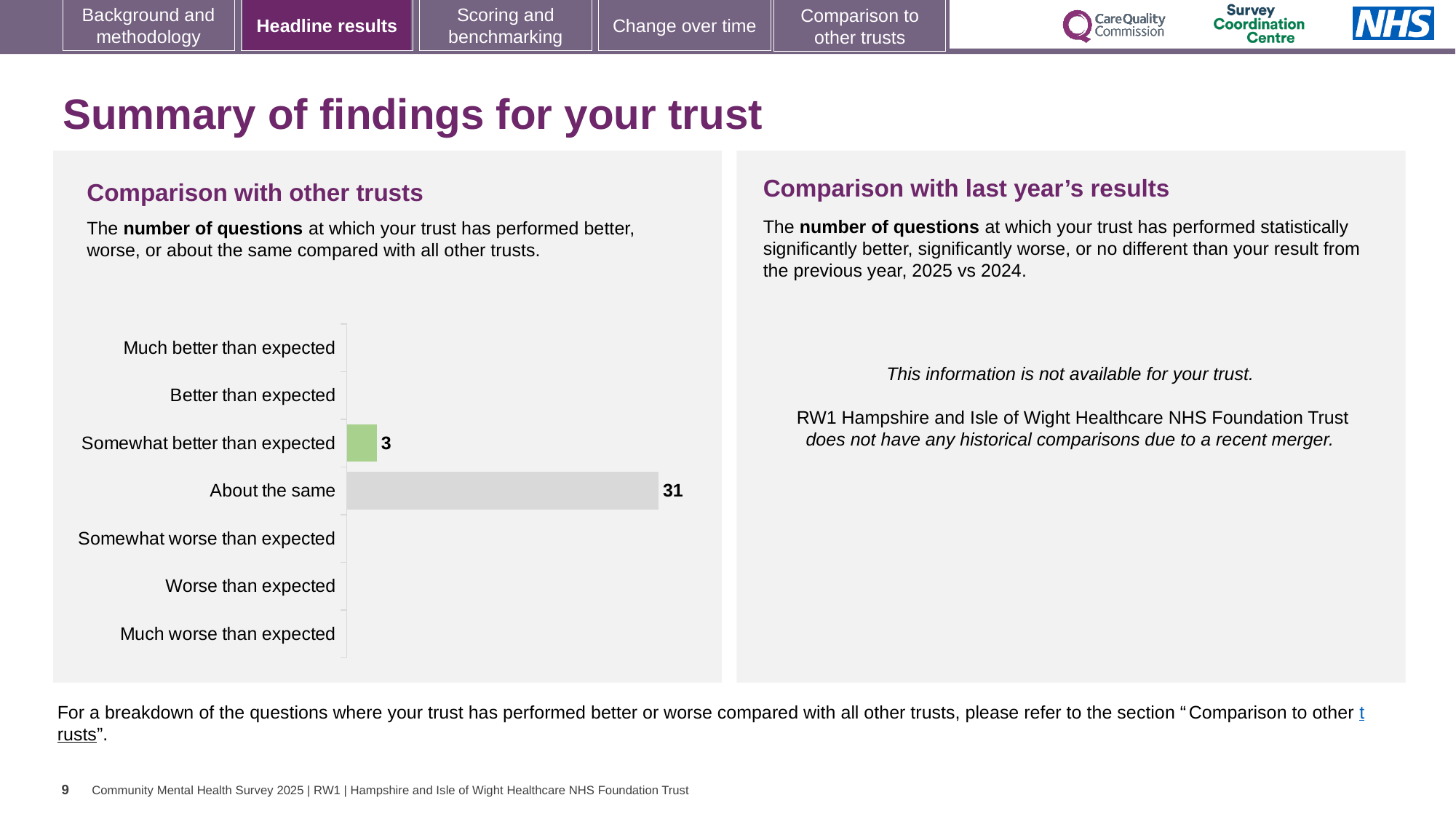
In the "Comparison with other trusts" chart, which is larger: the value for "About the same" or the value for "Somewhat better than expected"? About the same How many categories are listed on the vertical axis of the "Comparison with other trusts" chart? 7 In the "Comparison with other trusts" chart, what is the value for "About the same"? 31 What is the title of the panel containing the bar chart on the left of the slide? Comparison with other trusts What kind of chart is shown under "Comparison with other trusts"? bar chart In the "Comparison with other trusts" chart, what is the value for "Somewhat better than expected"? 3 In the "Comparison with other trusts" chart, how many categories have a visible bar? 2 In the "Comparison with other trusts" chart, what is the difference between the values for "About the same" and "Somewhat better than expected"? 28 In the "Comparison with other trusts" chart, which category is listed at the top of the vertical axis? Much better than expected In the "Comparison with other trusts" chart, what colour is the bar for "Somewhat better than expected"? green In the "Comparison with other trusts" chart, which category has the highest value? About the same